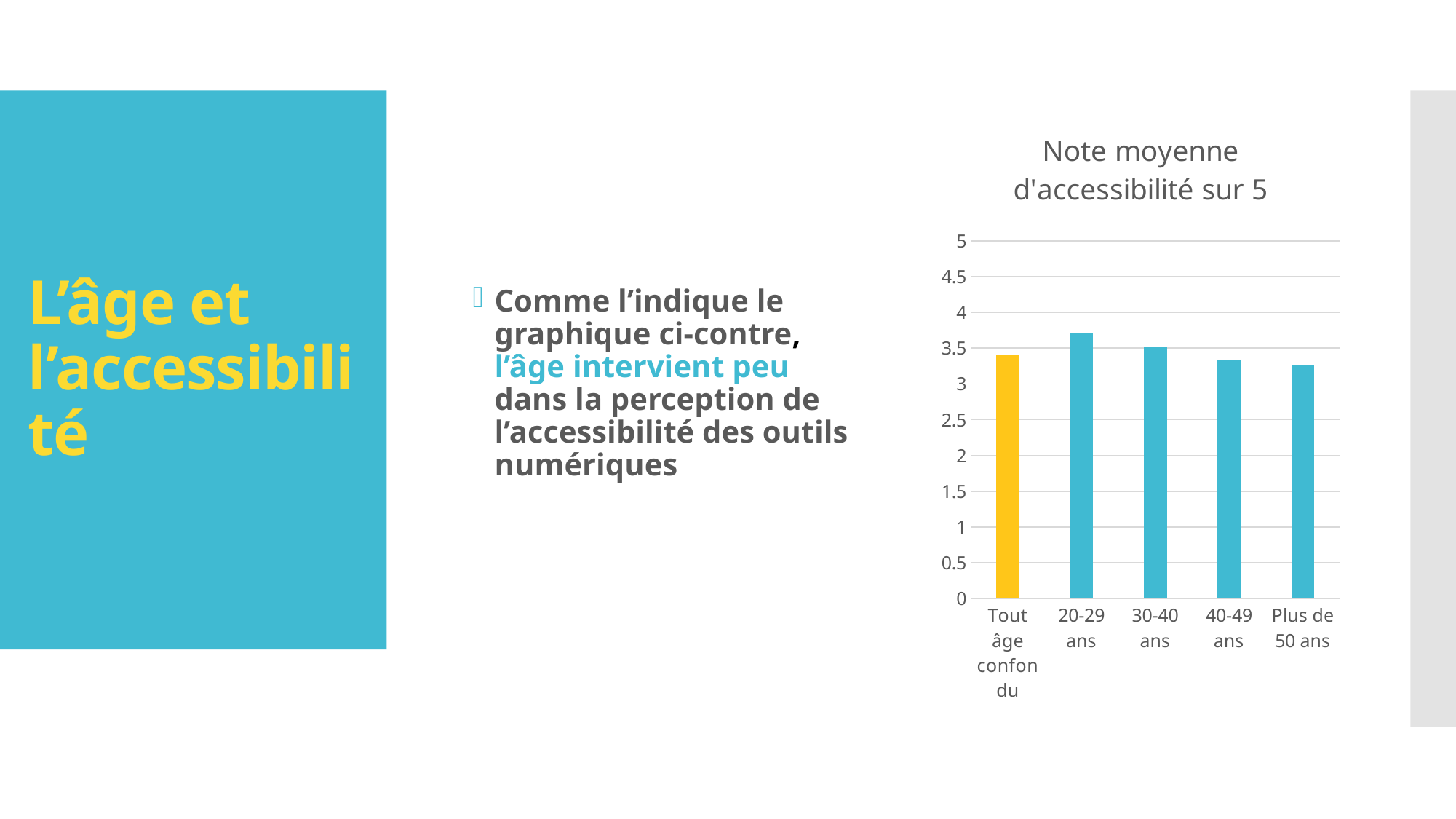
Is the value for Tout âge confondu greater or less than 4? less Do the values rise or fall across the age groups from 20-29 ans to Plus de 50 ans? fall Is the value for 40-49 ans greater or less than 3.5? less How many categories are plotted on the x axis of the chart? 5 Which bar is coloured differently (yellow) from the others? Tout âge confondu What kind of chart is shown on the slide? bar chart What is the title of the chart? Note moyenne d'accessibilité sur 5 Is the value for 20-29 ans greater or less than 3.5? greater Which is larger, the value for 20-29 ans or the value for Plus de 50 ans? 20-29 ans Which is larger, the value for 20-29 ans or the value for 30-40 ans? 20-29 ans Which category has the highest average accessibility score? 20-29 ans